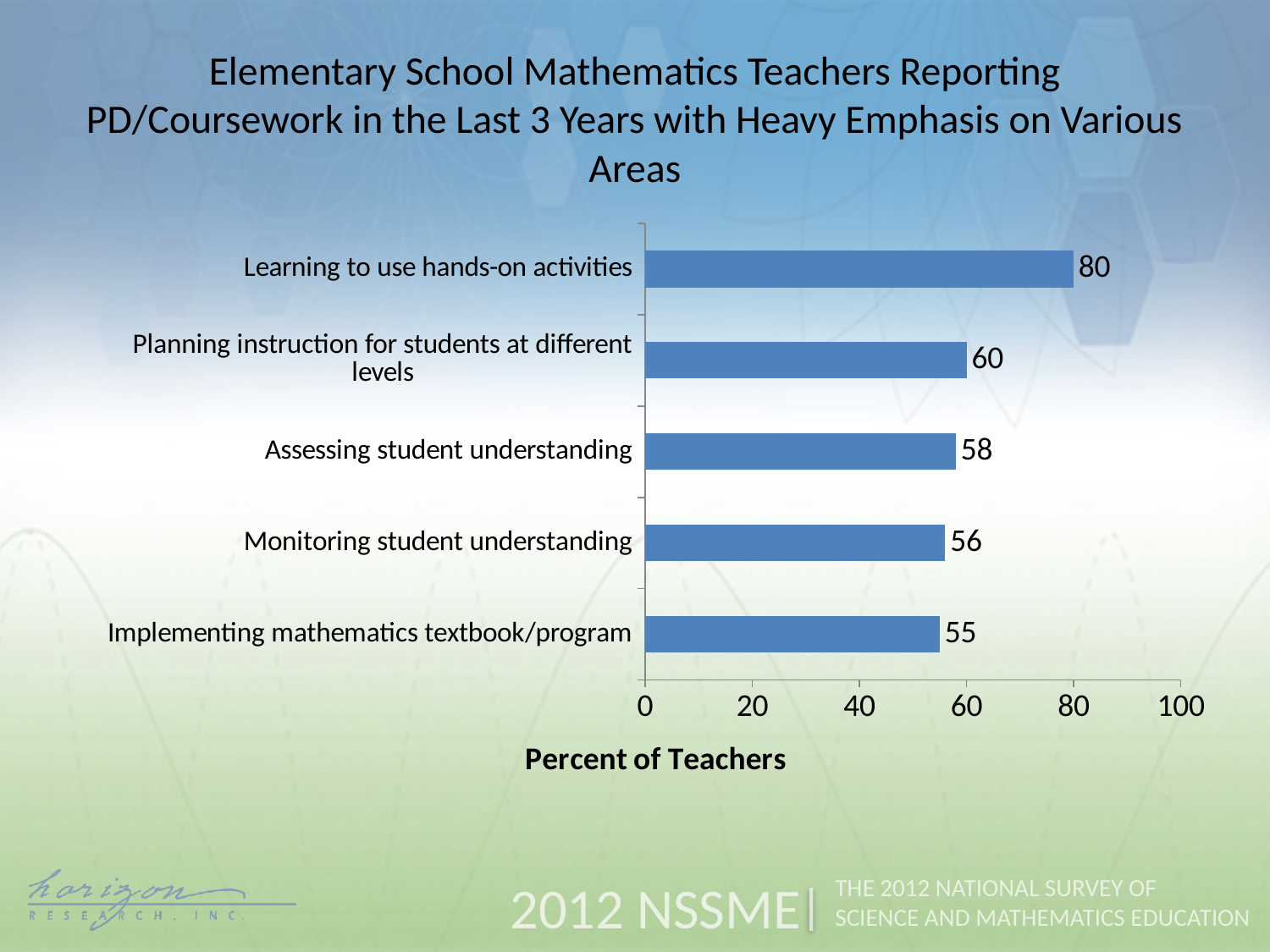
What is the value for Implementing mathematics textbook/program? 55 What is the value for Planning instruction for students at different levels? 60 Is the value for Monitoring student understanding greater or less than 60? less How many areas are shown in the chart? 5 What kind of chart is shown on the slide? bar chart What percent of teachers reported PD/coursework with heavy emphasis on learning to use hands-on activities? 80 What is the difference between the values for Assessing student understanding and Monitoring student understanding? 2 What is the label of the horizontal axis? Percent of Teachers Which area has the highest percent of teachers? Learning to use hands-on activities Which is larger, the value for Assessing student understanding or Implementing mathematics textbook/program? Assessing student understanding Which area has the lowest percent of teachers? Implementing mathematics textbook/program What is the difference between the values for Learning to use hands-on activities and Planning instruction for students at different levels? 20